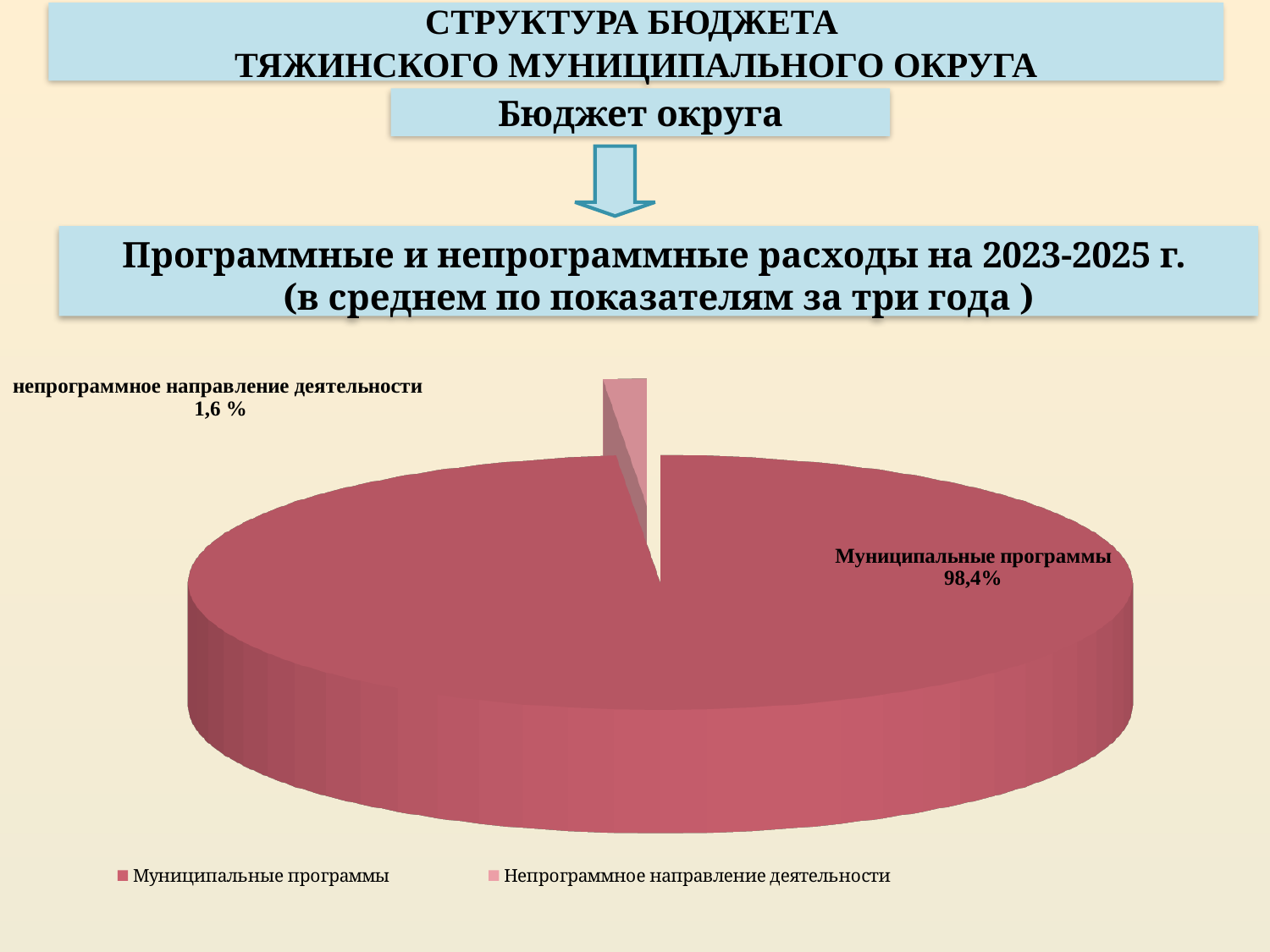
Which legend entry is shown in the lighter pink colour? Непрограммное направление деятельности What share of the pie does Муниципальные программы hold? 98,4% What kind of chart is shown on the slide? Pie chart Which slice of the pie is the smallest? непрограммное направление деятельности Which is larger: Муниципальные программы or непрограммное направление деятельности? Муниципальные программы What share of the pie does непрограммное направление деятельности hold? 1,6 % What is the difference in percentage points between Муниципальные программы and непрограммное направление деятельности? 96,8 Which slice of the pie is the largest? Муниципальные программы How many entries does the legend list? 2 How many slices does the pie chart have? 2 What is the title of the chart? Программные и непрограммные расходы на 2023-2025 г. (в среднем по показателям за три года )